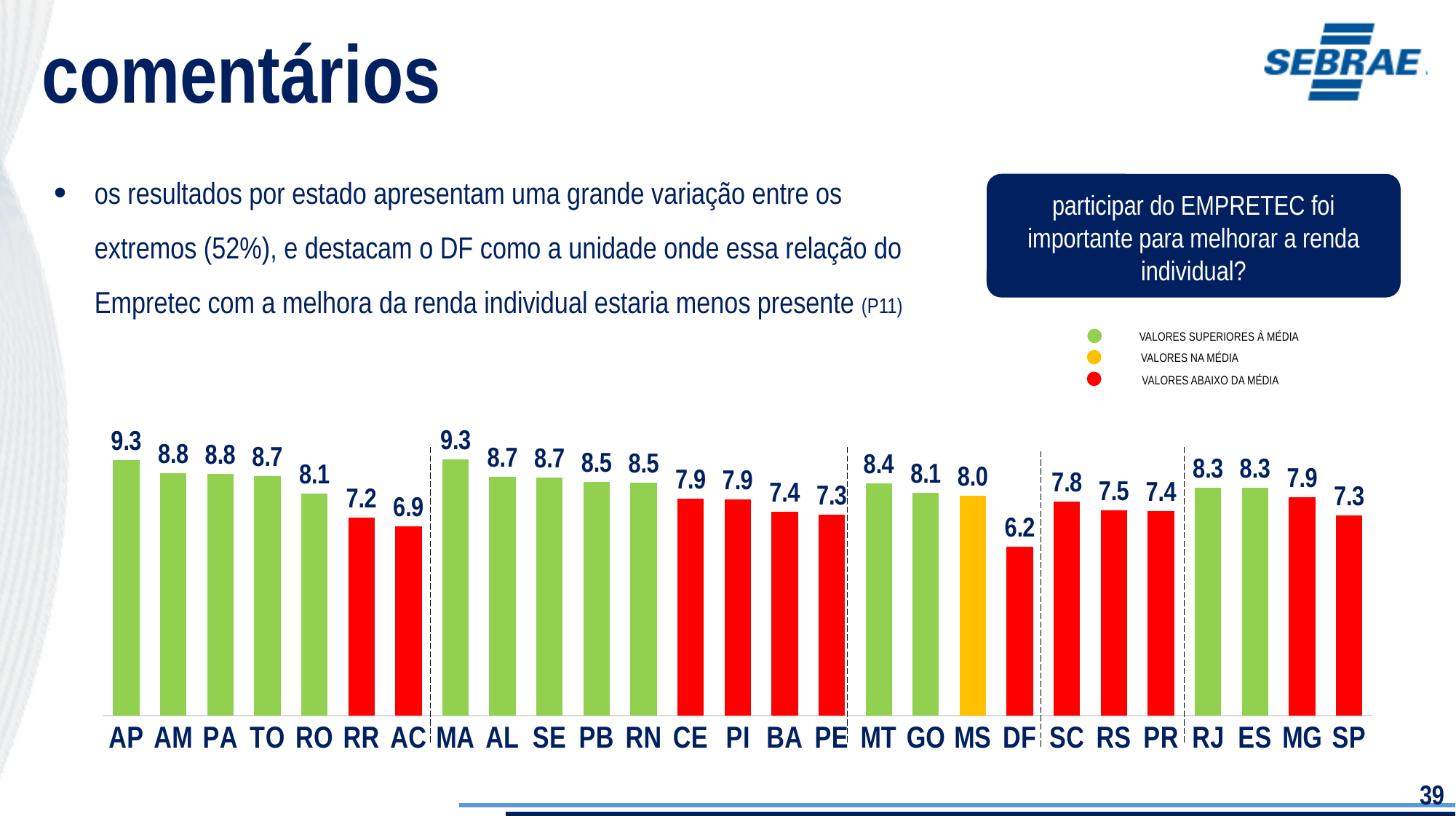
What is the value for MS? 8.0 What is the value for RR? 7.2 Which has a larger value, RJ or MG? RJ What is the difference between the values for MT and GO? 0.3 How many entries does the legend list? 3 Which state has the lowest value? DF What kind of chart is shown? bar chart Which has a larger value, AC or PE? PE What is the difference between the values for AP and DF? 3.1 How many states are shown on the chart? 27 What is the value for DF? 6.2 What is the value for SC? 7.8